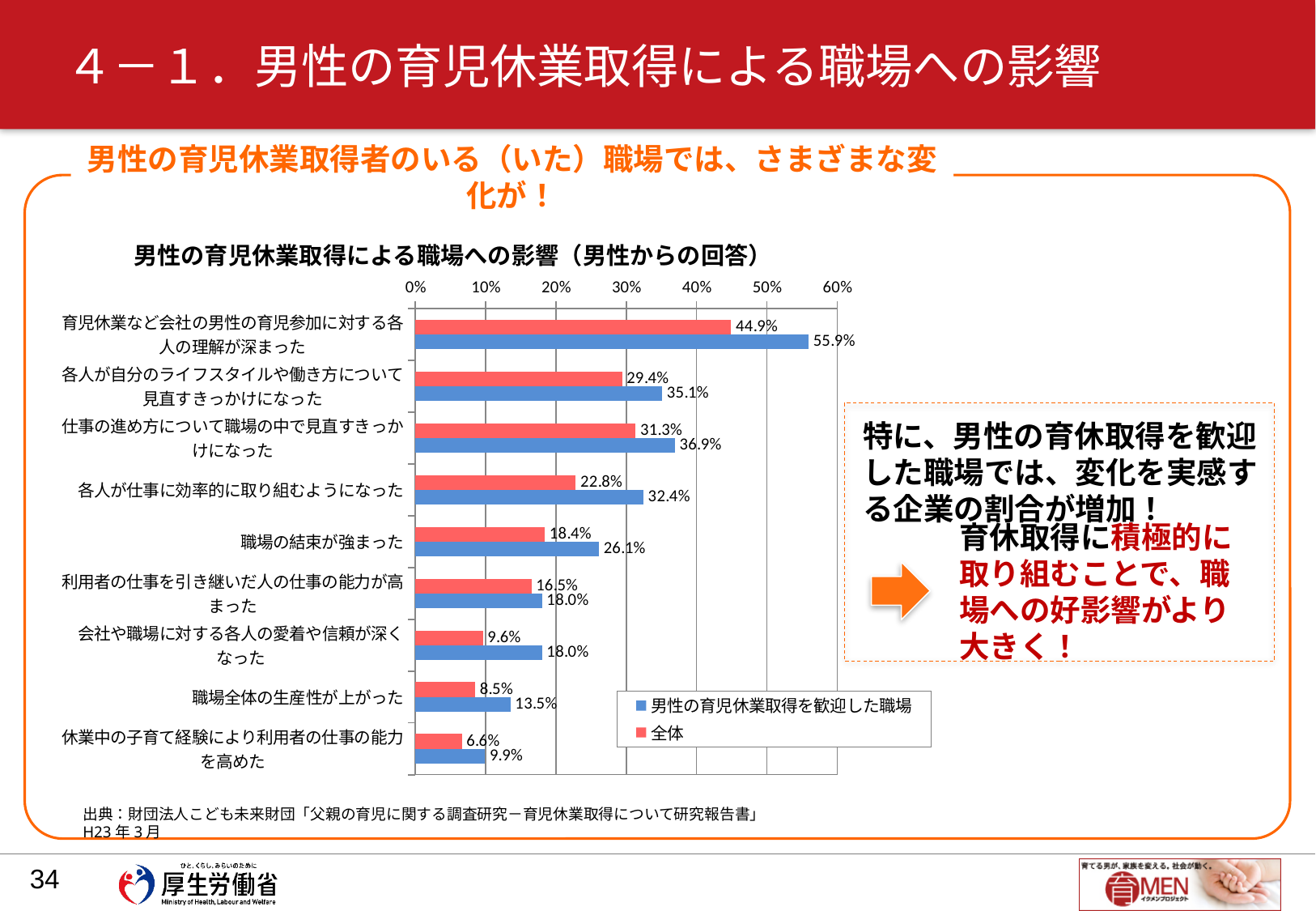
Is the 「全体」 value for 「仕事の進め方について職場の中で見直すきっかけになった」 greater or less than 30%? greater What is the value for 「全体」 for 「職場全体の生産性が上がった」? 8.5% What is the difference between the 「男性の育児休業取得を歓迎した職場」 and 「全体」 values for 「各人が仕事に効率的に取り組むようになった」? 9.6% How many series does the legend list? 2 How many categories are plotted in the chart? 9 What is the value for 「全体」 for 「職場の結束が強まった」? 18.4% What is the value for 「男性の育児休業取得を歓迎した職場」 for 「育児休業など会社の男性の育児参加に対する各人の理解が深まった」? 55.9% Which colour represents the 「全体」 series in the chart? red What type of chart is shown on the slide? bar chart Which category has the highest value for 「男性の育児休業取得を歓迎した職場」? 育児休業など会社の男性の育児参加に対する各人の理解が深まった For 「会社や職場に対する各人の愛着や信頼が深くなった」, which series has the larger value, 「男性の育児休業取得を歓迎した職場」 or 「全体」? 男性の育児休業取得を歓迎した職場 Which category has the lowest value for 「全体」? 休業中の子育て経験により利用者の仕事の能力を高めた